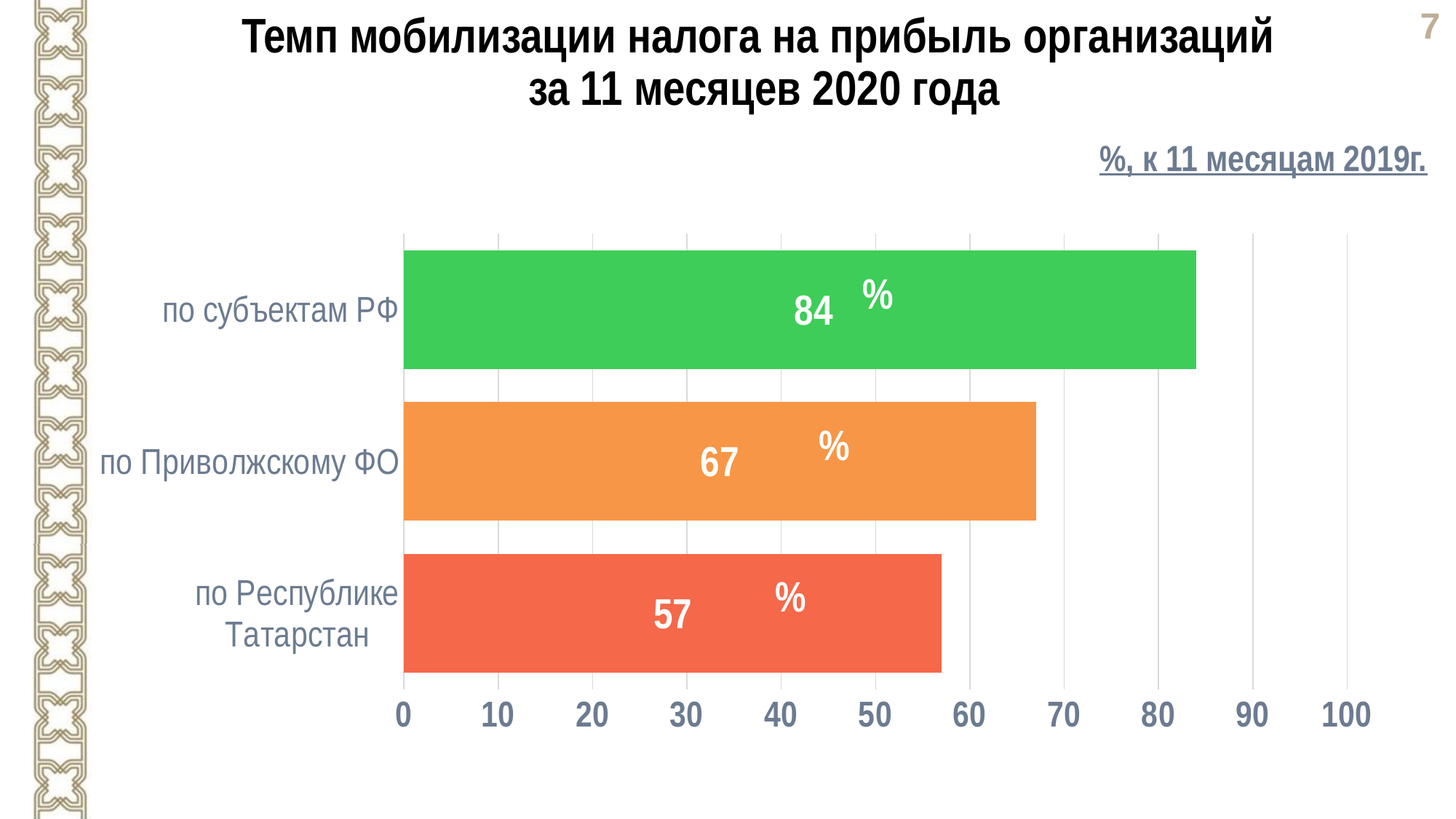
What is the difference between the values for по субъектам РФ and по Республике Татарстан? 27 What kind of chart is shown on the slide? bar chart What is the value for по субъектам РФ? 84 Is the value for по субъектам РФ greater or less than 80? greater Which is larger, the value for по Приволжскому ФО or the value for по Республике Татарстан? по Приволжскому ФО What is the value for по Приволжскому ФО? 67 What is the title of the chart? Темп мобилизации налога на прибыль организаций за 11 месяцев 2020 года Which category has the highest value? по субъектам РФ Which category has the lowest value? по Республике Татарстан What is the value for по Республике Татарстан? 57 What is the difference between the values for по Приволжскому ФО and по Республике Татарстан? 10 How many categories are shown in the chart? 3